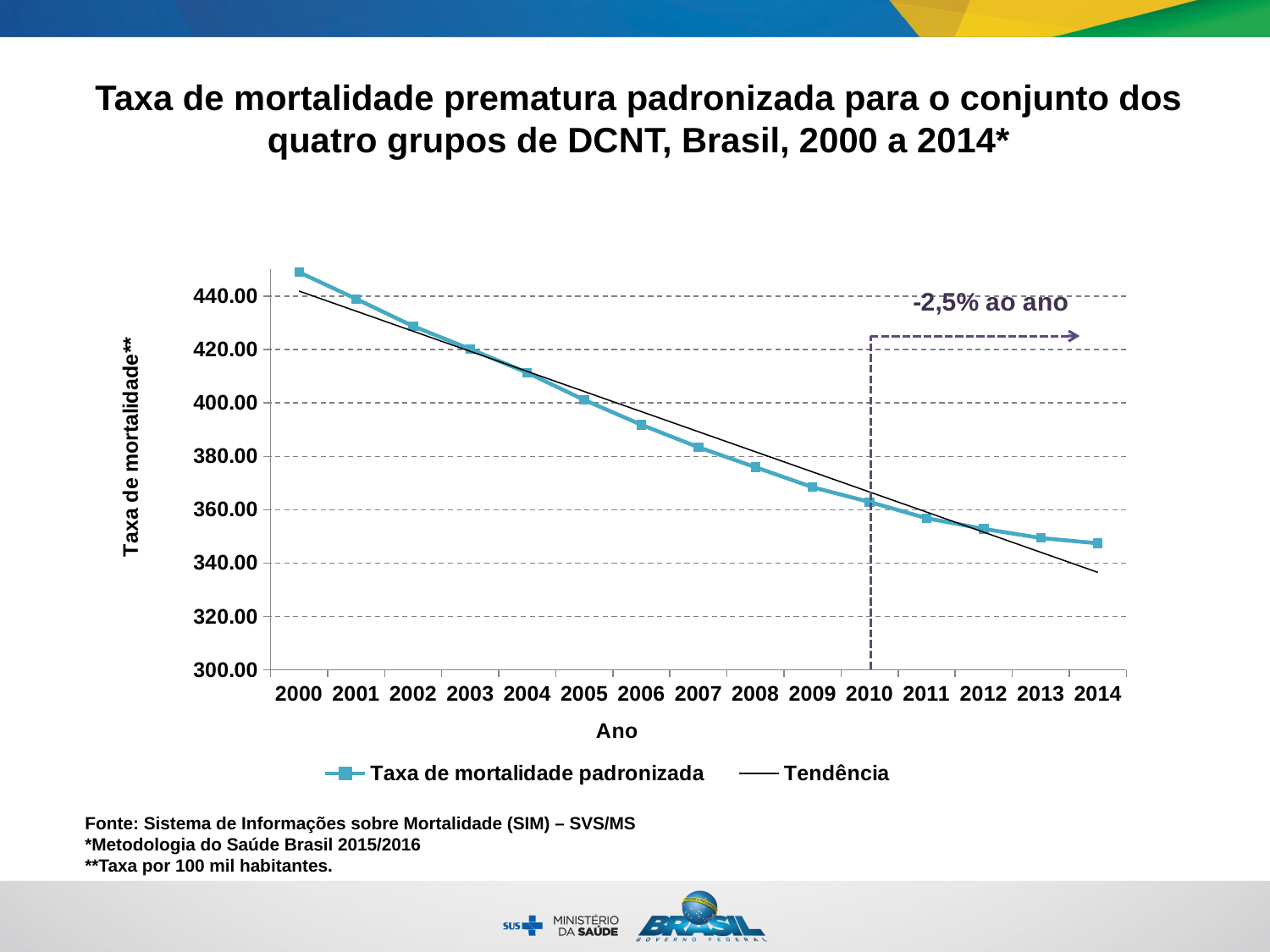
How many years are plotted along the x axis? 15 In which year is the standardized mortality rate highest? 2000 Is the standardized mortality rate for 2002 greater or less than 420? greater Which year has the larger standardized mortality rate, 2003 or 2009? 2003 In which year is the standardized mortality rate lowest? 2014 How many series does the legend list? 2 Is the standardized mortality rate for 2014 greater or less than 340? greater Does the standardized mortality rate rise or fall from 2000 to 2014? Fall Is the standardized mortality rate for 2006 greater or less than 400? less What annual rate of change is annotated on the chart? -2,5% ao ano What kind of chart is shown on the slide? Line chart